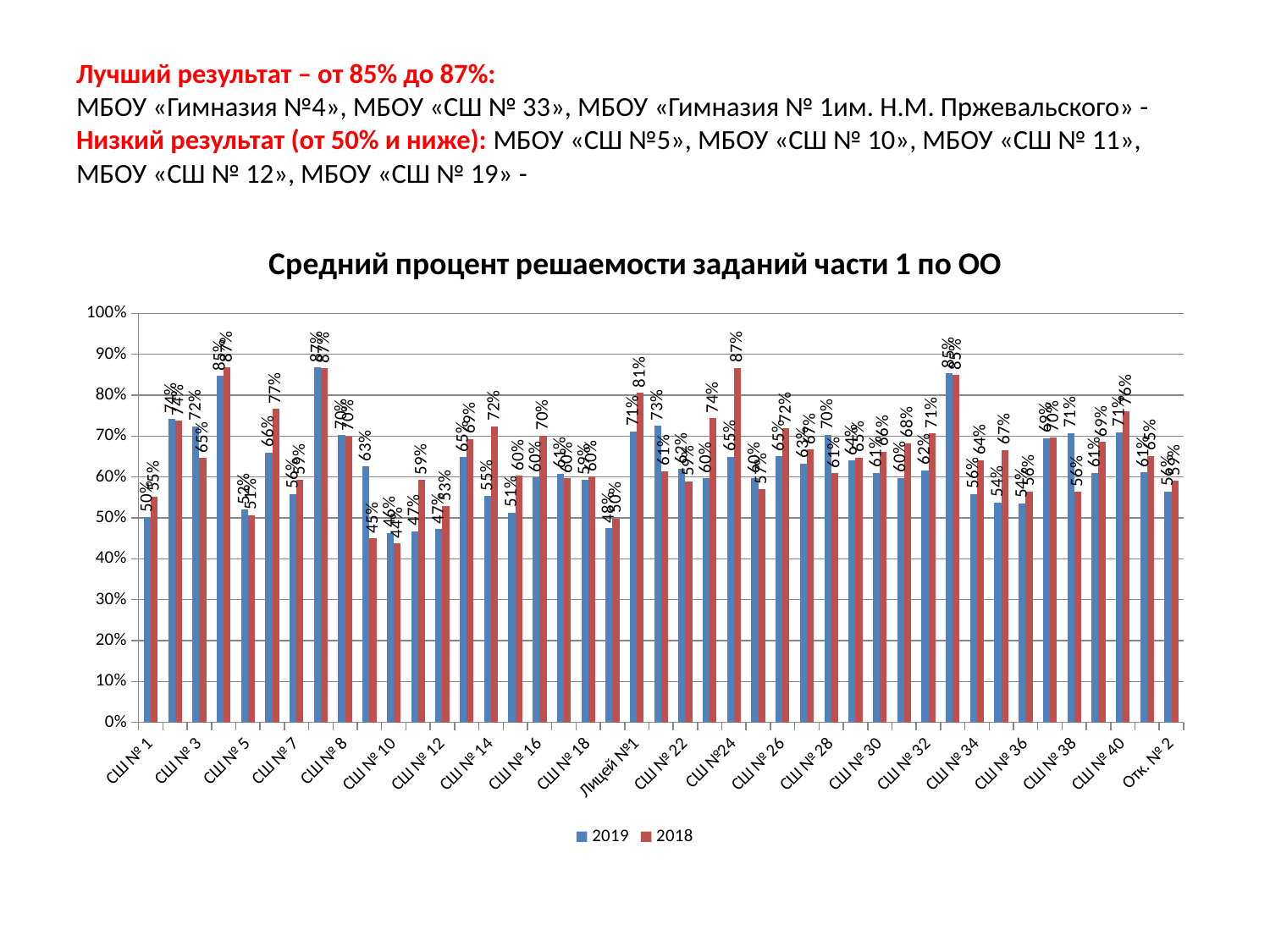
What kind of chart is shown on the slide? bar chart What is the 2019 value for СШ № 1? 50% What is the 2018 value for СШ № 1? 55% What is the title of the chart? Средний процент решаемости заданий части 1 по ОО Which years are listed in the chart legend? 2019 and 2018 What is the 2018 value for СШ № 14? 72% Is the 2019 value for СШ № 8 greater or less than 60%? greater What is the 2018 value for Лицей №1? 81% For СШ № 1, which series has the larger value, 2019 or 2018? 2018 What is the difference between the 2018 and 2019 values for Лицей №1? 10 percentage points What is the 2018 value for СШ №24? 87% How many series does the legend of the chart list? 2